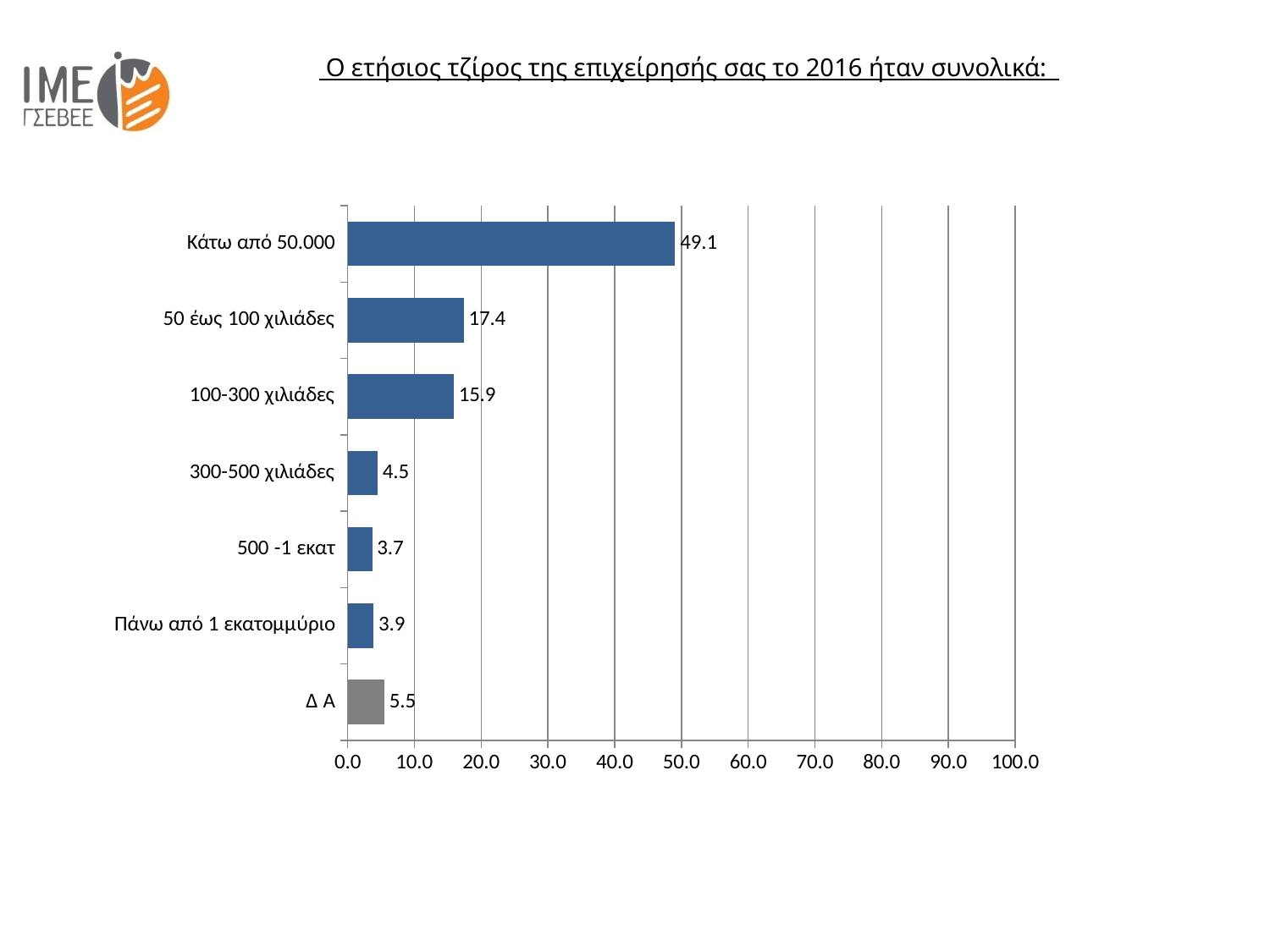
What kind of chart is shown on the slide? bar chart Which is larger, the value for '50 έως 100 χιλιάδες' or the value for '100-300 χιλιάδες'? 50 έως 100 χιλιάδες Which category's bar is coloured grey rather than blue? Δ Α Which category has the highest value? Κάτω από 50.000 What is the difference between the values for '300-500 χιλιάδες' and '500 -1 εκατ'? 0.8 What is the value for the category 'Κάτω από 50.000'? 49.1 What is the difference between the values for 'Κάτω από 50.000' and '50 έως 100 χιλιάδες'? 31.7 Is the value for 'Κάτω από 50.000' greater or less than 40.0? greater What is the value for the category 'Δ Α'? 5.5 What is the value for the category '100-300 χιλιάδες'? 15.9 Which category has the lowest value? 500 -1 εκατ How many categories are shown in the chart? 7